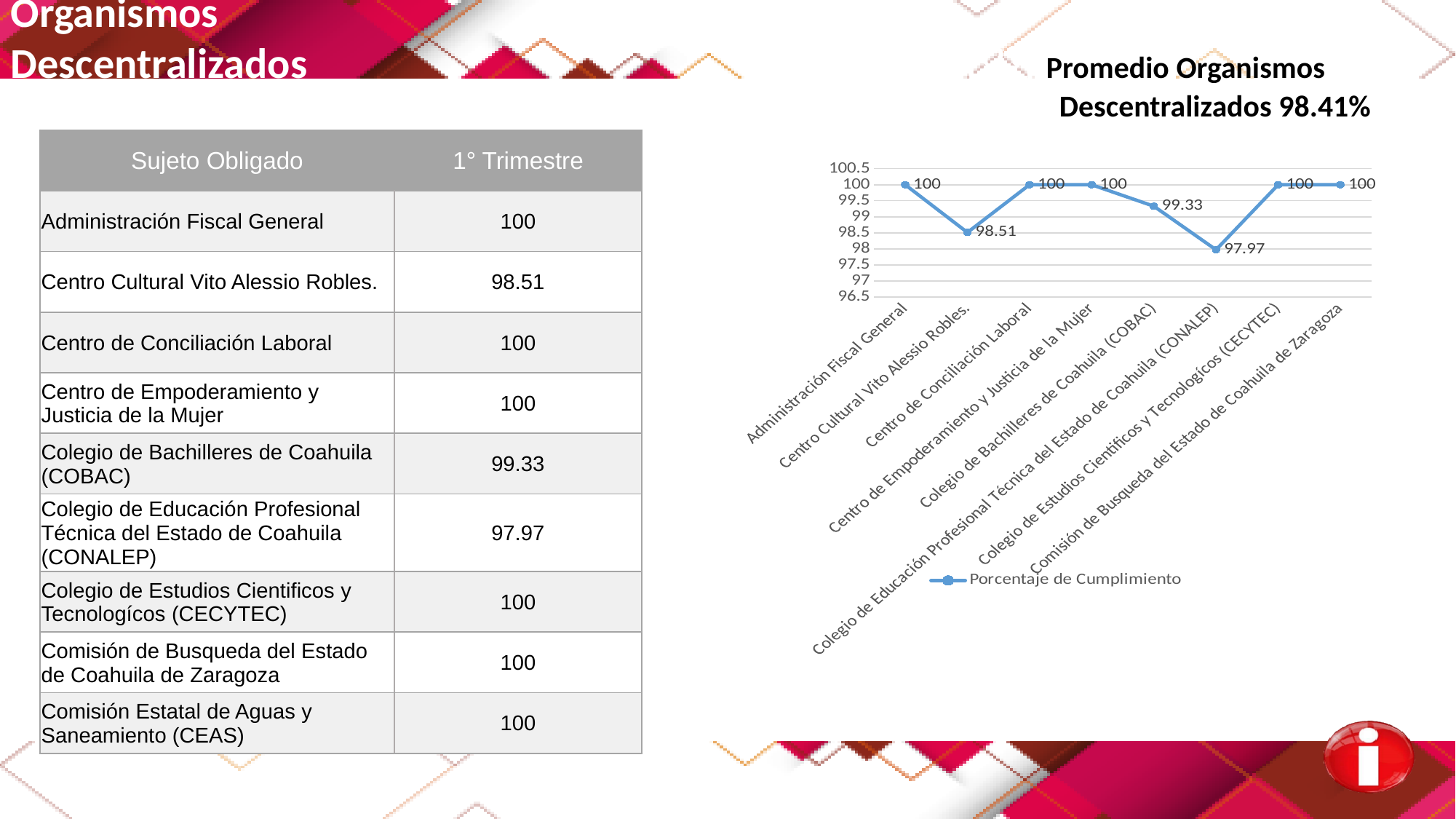
How many series does the chart legend list? 1 Which category has the lowest value in the chart? Colegio de Educación Profesional Técnica del Estado de Coahuila (CONALEP) What is the difference between the values for Colegio de Bachilleres de Coahuila (COBAC) and Colegio de Educación Profesional Técnica del Estado de Coahuila (CONALEP)? 1.36 What is the value plotted for Colegio de Educación Profesional Técnica del Estado de Coahuila (CONALEP)? 97.97 What is the value plotted for Centro Cultural Vito Alessio Robles? 98.51 How many categories are plotted on the x axis of the chart? 8 What is the name of the series shown in the chart legend? Porcentaje de Cumplimiento Is the value for Colegio de Educación Profesional Técnica del Estado de Coahuila (CONALEP) greater or less than 98? less Which is larger, the value for Centro Cultural Vito Alessio Robles or the value for Colegio de Bachilleres de Coahuila (COBAC)? Colegio de Bachilleres de Coahuila (COBAC) What is the value plotted for Administración Fiscal General? 100 What is the value plotted for Colegio de Bachilleres de Coahuila (COBAC)? 99.33 What kind of chart is shown on the slide? line chart